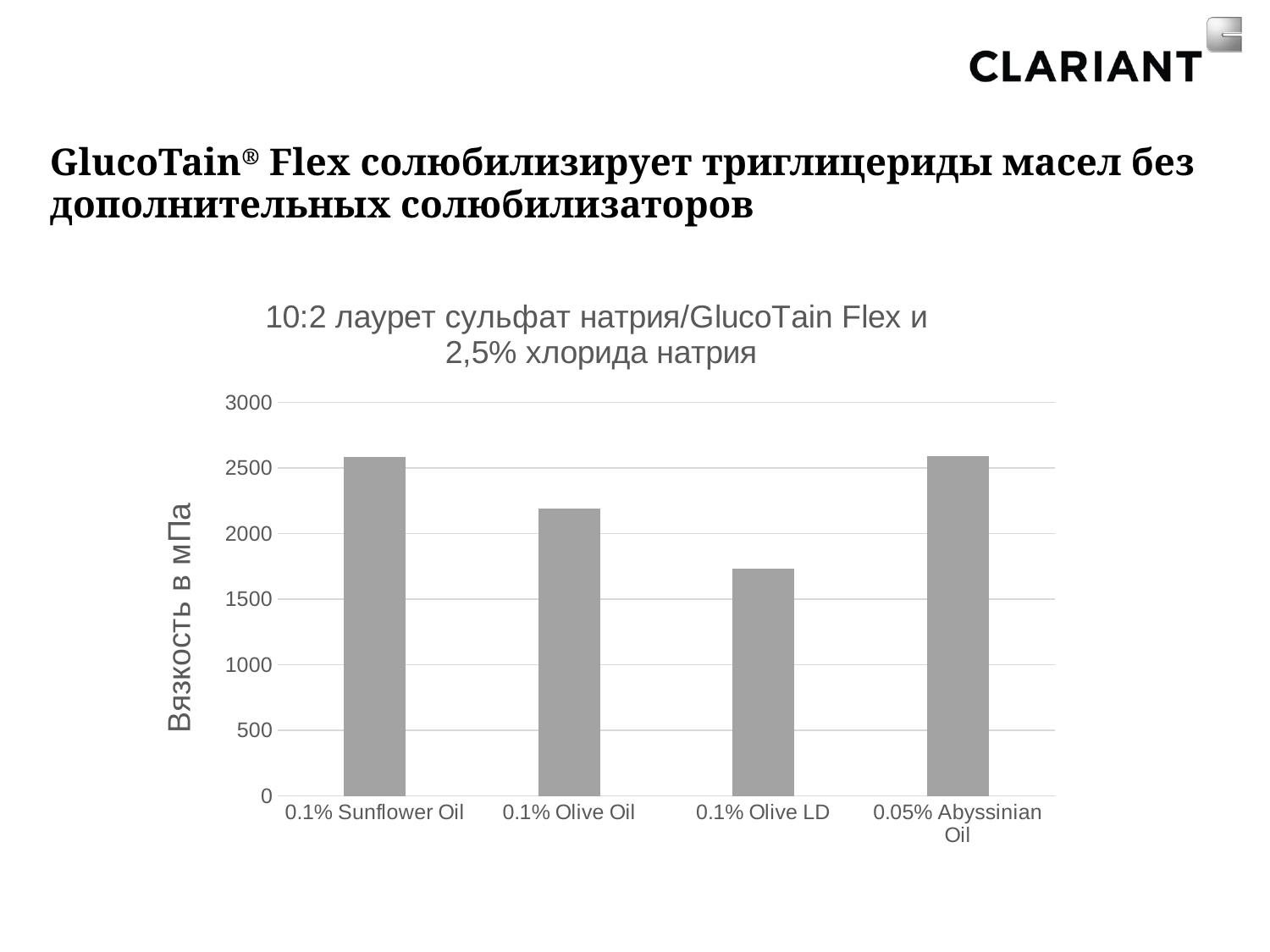
How many categories are plotted on the x axis of the chart? 4 What kind of chart is shown on the slide? bar chart Is the value for 0.1% Olive LD greater or less than 2000? less Which is larger, the value for 0.1% Olive Oil or the value for 0.1% Olive LD? 0.1% Olive Oil What is the label of the vertical axis of the chart? Вязкость в мПа Which category has the lowest value in the chart? 0.1% Olive LD Is the value for 0.05% Abyssinian Oil greater or less than 2500? greater Is the value for 0.1% Sunflower Oil greater or less than 2500? greater Which is larger, the value for 0.1% Sunflower Oil or the value for 0.1% Olive Oil? 0.1% Sunflower Oil What is the title of the chart? 10:2 лаурет сульфат натрия/GlucoTain Flex и 2,5% хлорида натрия